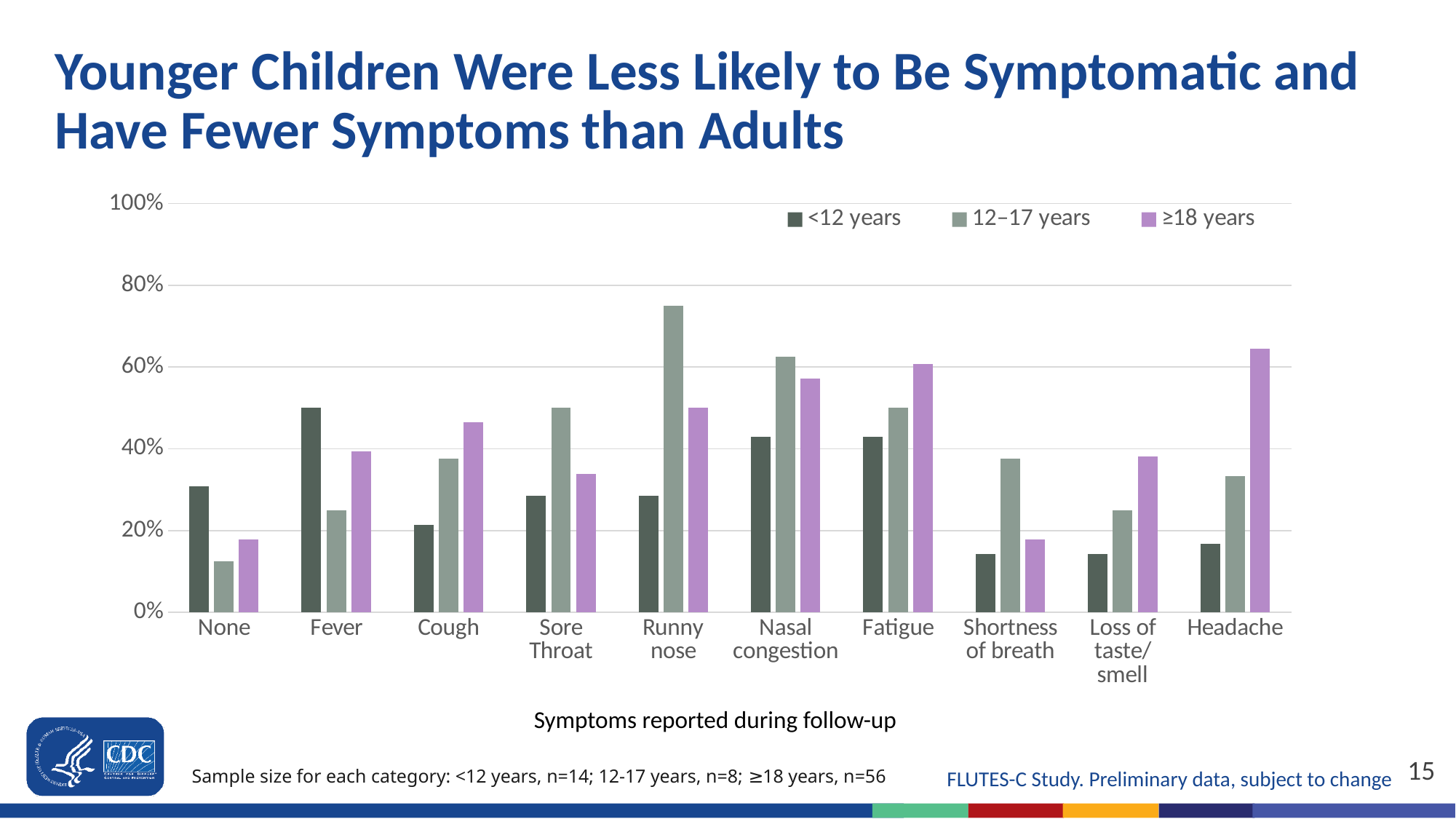
What is the x-axis title of the chart? Symptoms reported during follow-up How many series does the legend list? 3 For the <12 years series, which symptom has the highest bar? Fever For Headache, which series has the larger value: ≥18 years or 12–17 years? ≥18 years For the 12–17 years series, which category has the lowest bar? None How many symptom categories are shown on the x axis? 10 For Fever, which series has the larger value: <12 years or 12–17 years? <12 years What kind of chart is shown on the slide? bar chart Is the value for None in the <12 years series greater or less than 40%? less For the 12–17 years series, which symptom has the highest bar? Runny nose Is the value for Runny nose in the 12–17 years series greater or less than 60%? greater Is the value for Shortness of breath in the ≥18 years series greater or less than 20%? less